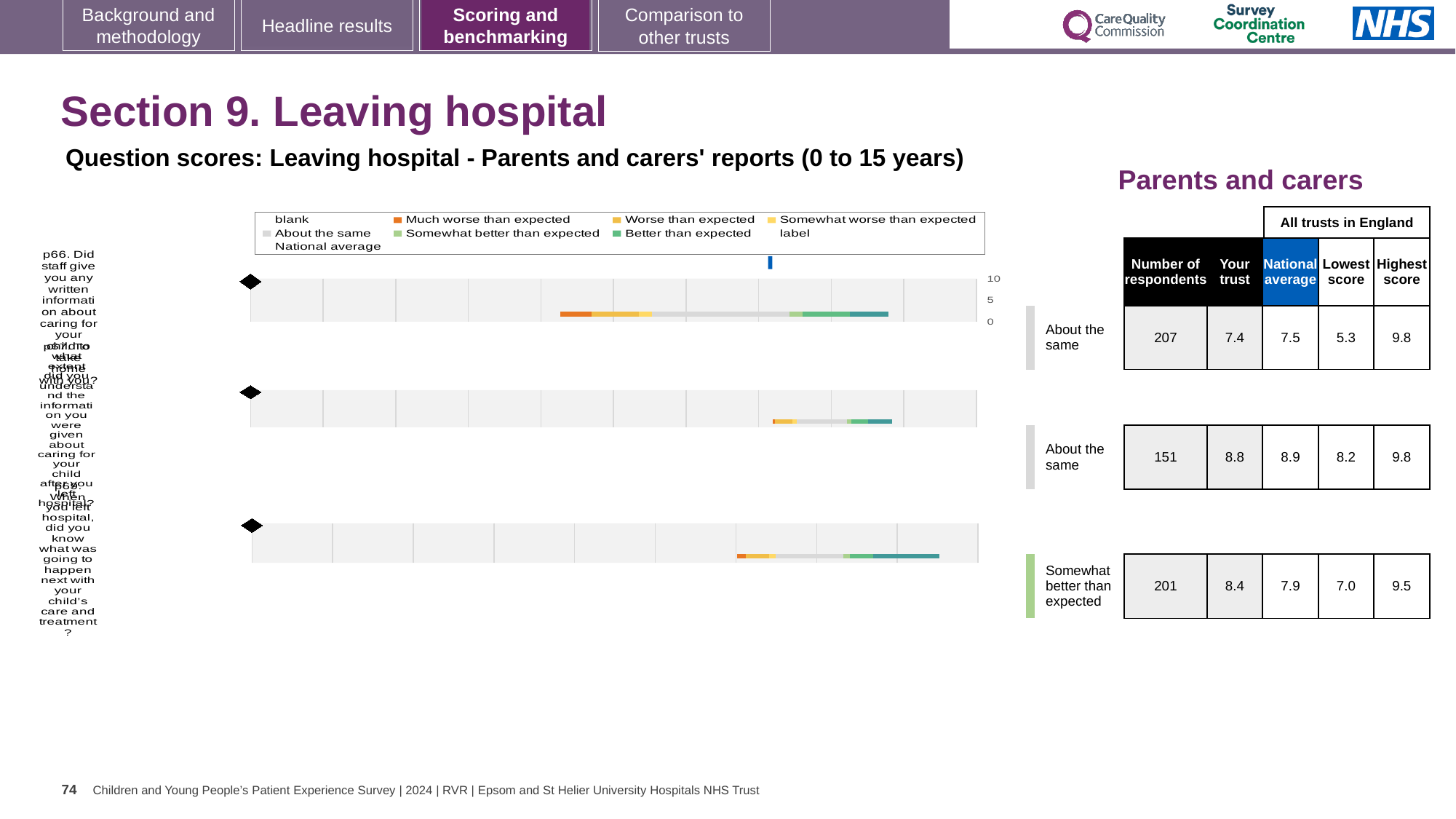
For the bottom chart (p68), what is the difference between the 'Your trust' score and the national average? 0.5 For the top chart (p66), which is larger: the 'Your trust' score or the national average? national average Which of the three charts has the highest 'Your trust' score? the middle chart For the top chart (p66), how many respondents are listed? 207 For the top chart (p66), what is the national average score shown beside it? 7.5 For the bottom chart (p68), what is the benchmark category shown beside it? Somewhat better than expected For the bottom chart (p68, did you know what was going to happen next), what is the 'Your trust' score? 8.4 For the top chart (p66, written information about caring for your child at home), what is the 'Your trust' score shown in the table beside it? 7.4 What kind of chart is used to show the question scores on this slide? bar chart What colour does the legend use for 'Much worse than expected'? orange How many question charts (bars) are shown on the slide? 3 For the middle chart, what is the lowest score across all trusts in England? 8.2